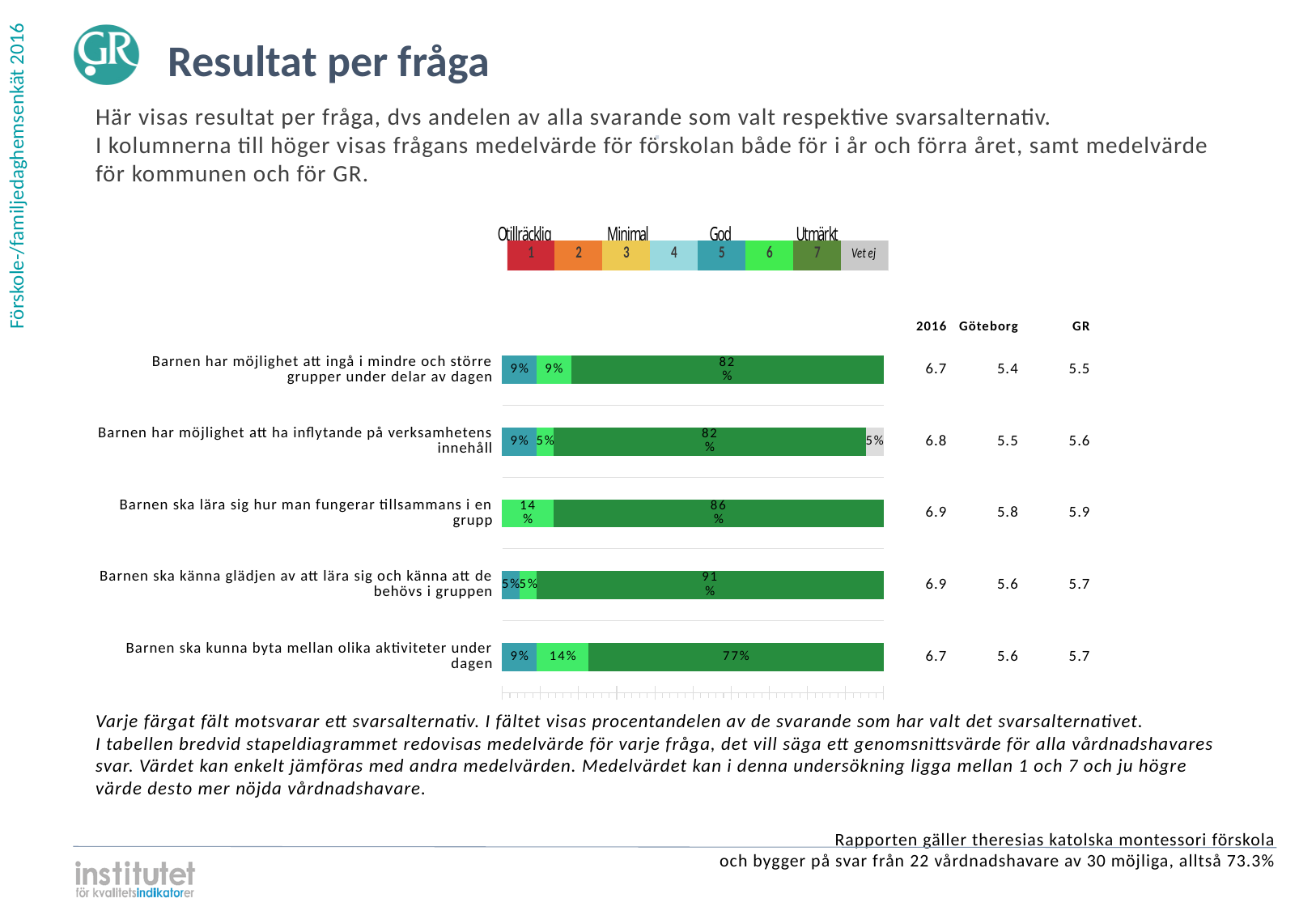
Which question has the largest share of respondents choosing 7 (Utmärkt)? Barnen ska känna glädjen av att lära sig och känna att de behövs i gruppen What label does the legend give to the value 5? God How many questions (categories) are plotted in the bar chart? 5 How many entries does the legend above the chart list? 8 What percentage of respondents chose 7 (Utmärkt) for 'Barnen ska känna glädjen av att lära sig och känna att de behövs i gruppen'? 91% What percentage of respondents answered 'Vet ej' for 'Barnen har möjlighet att ha inflytande på verksamhetens innehåll'? 5% What percentage of respondents chose 7 (Utmärkt) for 'Barnen ska kunna byta mellan olika aktiviteter under dagen'? 77% What is the difference between the 7 (Utmärkt) share for 'Barnen ska lära sig hur man fungerar tillsammans i en grupp' and for 'Barnen ska kunna byta mellan olika aktiviteter under dagen'? 9 percentage points Which question has the smallest share of respondents choosing 7 (Utmärkt)? Barnen ska kunna byta mellan olika aktiviteter under dagen Which question has a larger share of respondents choosing 6: 'Barnen ska kunna byta mellan olika aktiviteter under dagen' or 'Barnen har möjlighet att ha inflytande på verksamhetens innehåll'? Barnen ska kunna byta mellan olika aktiviteter under dagen What is the 2016 mean value shown for 'Barnen ska lära sig hur man fungerar tillsammans i en grupp'? 6.9 What kind of chart is shown on the slide? Stacked bar chart